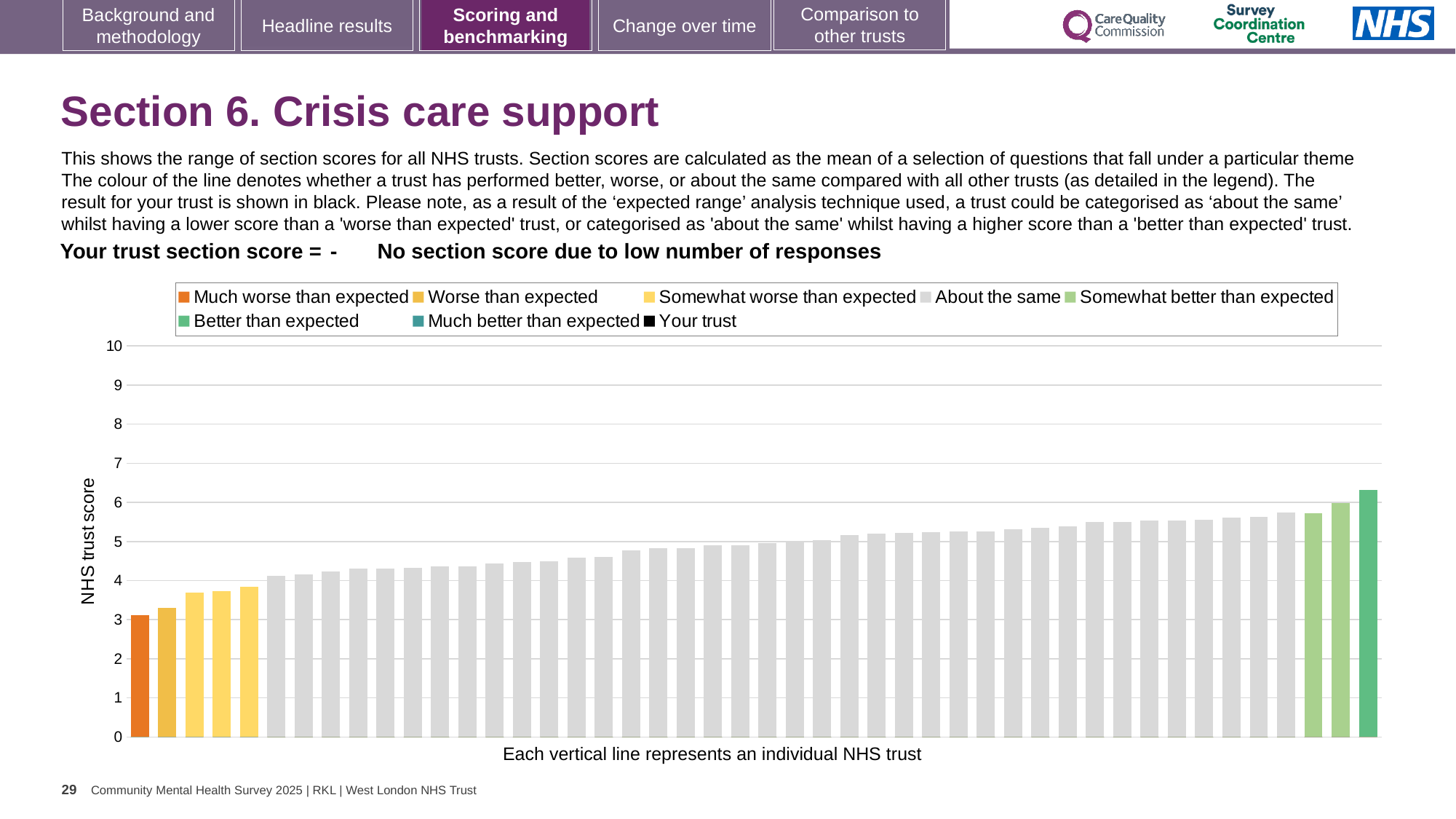
What kind of chart is shown on the slide? Bar chart Is the value of the tallest bar greater or less than 6? greater What is the label on the vertical axis of the chart? NHS trust score How many entries does the chart legend list? 8 What does each vertical line in the chart represent, according to the x-axis label? An individual NHS trust Which legend category does the shortest bar belong to? Much worse than expected Is the value of the shortest bar greater or less than 4? less Which legend category does the tallest bar belong to? Better than expected How many bars are coloured as 'Somewhat better than expected' (light green)? 2 Do the bar values rise or fall from left to right along the x axis? Rise How many bars are coloured as 'Much worse than expected' (orange)? 1 Is the value of the tallest bar greater or less than 7? less